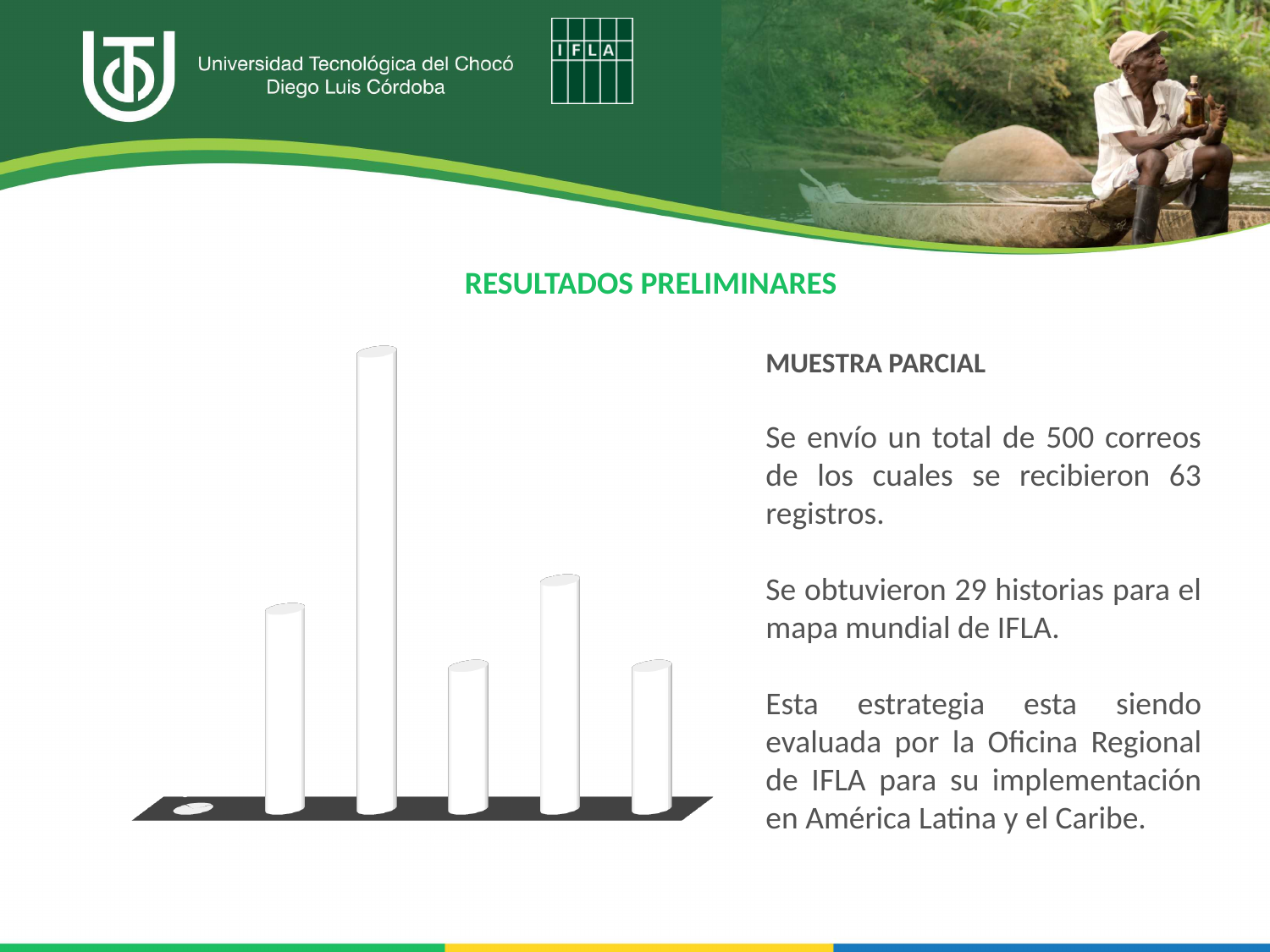
How many bars are plotted in the chart on the slide? 6 Does the chart on the slide display any axis labels or data labels? No In the chart, is the third bar from the left taller or shorter than the fifth bar from the left? taller What kind of chart is shown on the slide? bar chart What colour are the bars in the chart? white Counting from the left, which bar in the chart is the shortest? the first bar In the chart, is the second bar from the left taller or shorter than the fourth bar from the left? taller Counting from the left, which bar in the chart is the tallest? the third bar